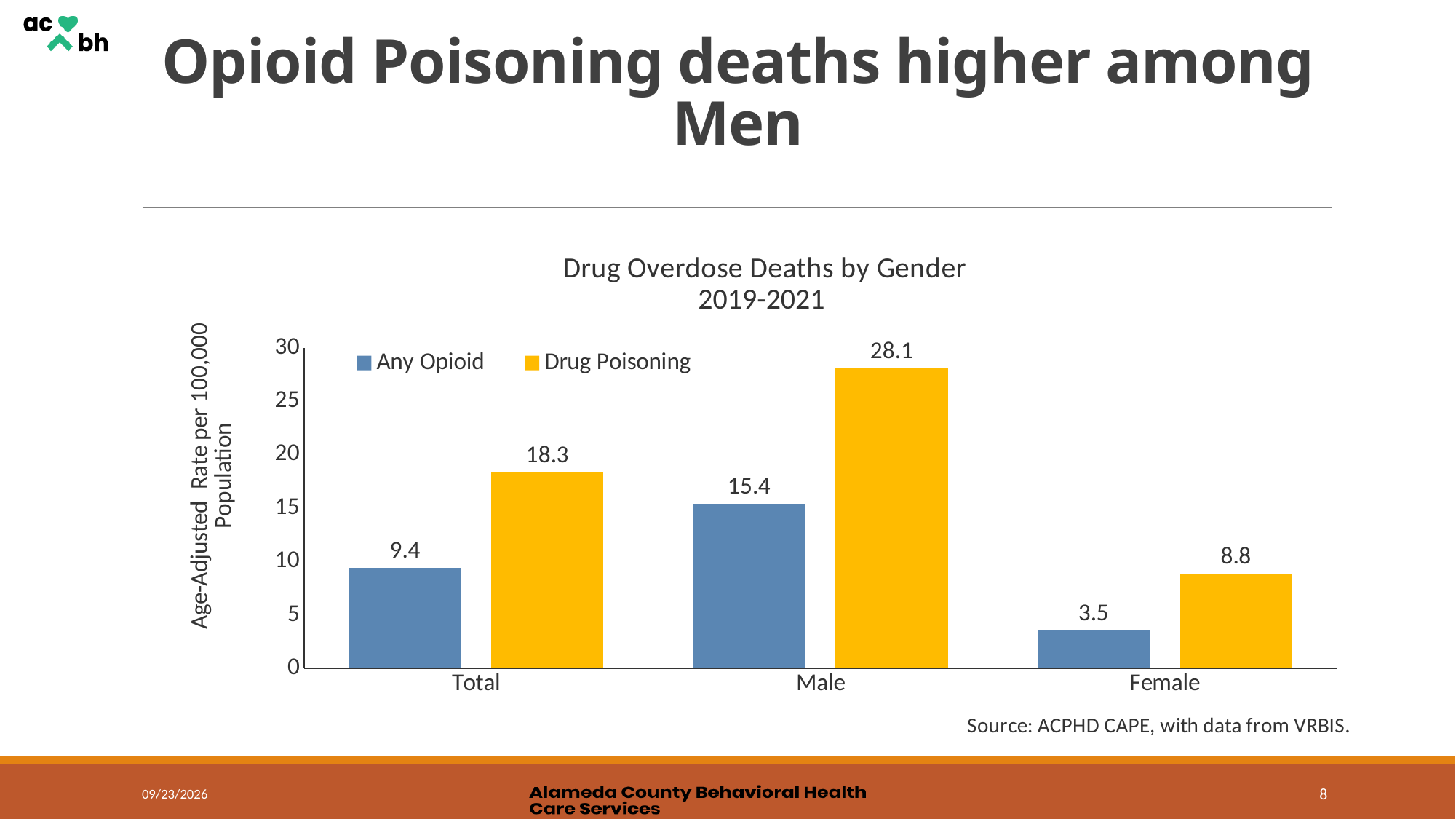
How many categories are shown on the x axis? 3 What is the difference between the Any Opioid rates for Male and Female? 11.9 What kind of chart is shown on the slide? Bar chart Which category has the highest Drug Poisoning rate? Male What is the Drug Poisoning rate for Total? 18.3 Which category has the lowest Any Opioid rate? Female How many series does the legend list? 2 What is the Any Opioid rate for Male? 15.4 Is the Drug Poisoning rate for Male greater or less than 25? greater Which is larger, the Any Opioid rate for Total or the Drug Poisoning rate for Female? Any Opioid rate for Total What is the difference between the Drug Poisoning rate and the Any Opioid rate for Male? 12.7 What is the Drug Poisoning rate for Female? 8.8